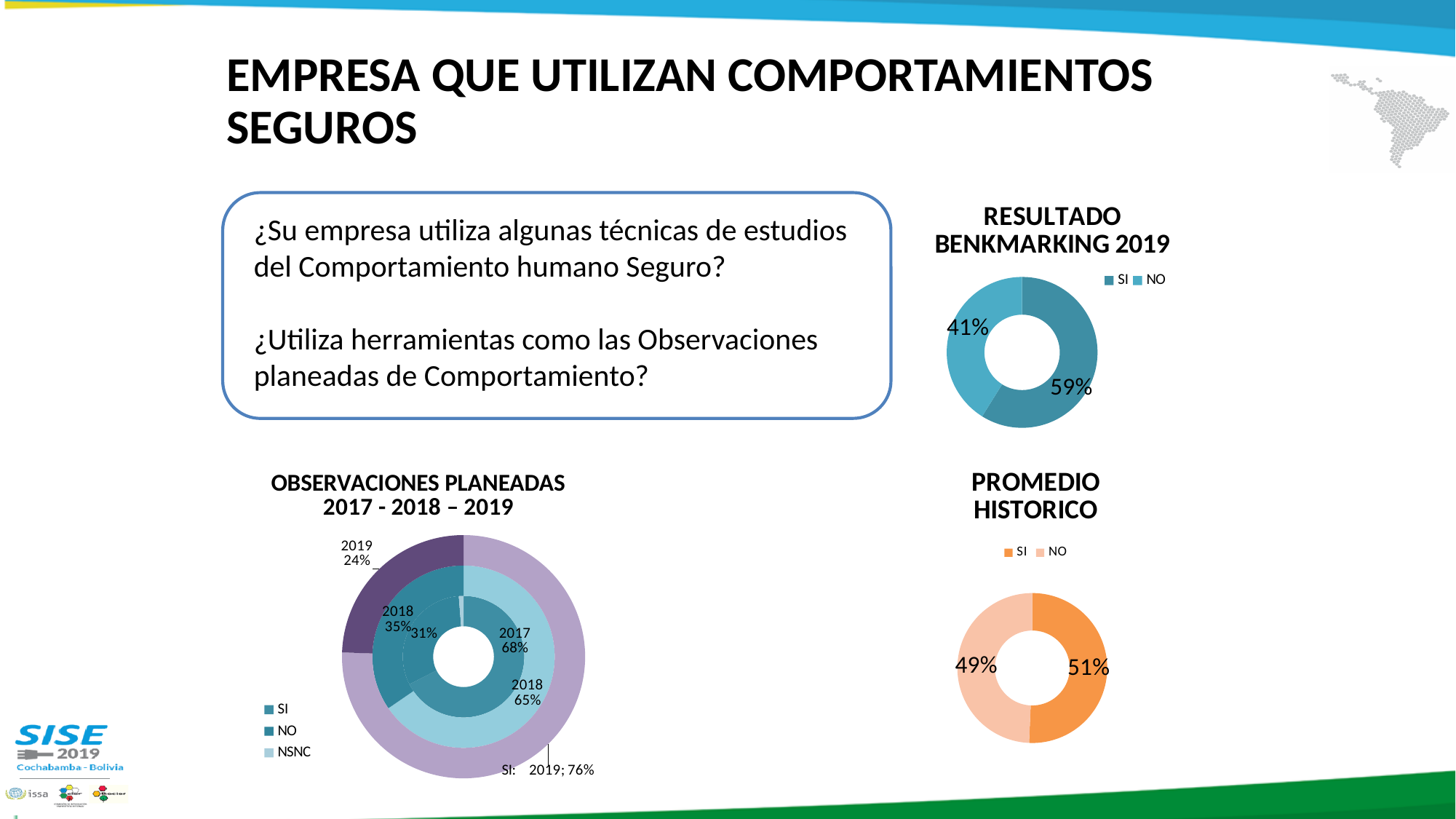
How many series does the legend of the PROMEDIO HISTORICO chart list? 2 In the OBSERVACIONES PLANEADAS 2017 - 2018 – 2019 chart, what is the NO percentage for 2018? 35% In the OBSERVACIONES PLANEADAS 2017 - 2018 – 2019 chart, what is the SI percentage for 2017? 68% In the RESULTADO BENKMARKING 2019 chart, what percentage answered NO? 41% What kind of chart is the RESULTADO BENKMARKING 2019 chart? Doughnut (pie) chart In the OBSERVACIONES PLANEADAS 2017 - 2018 – 2019 chart, what is the SI percentage for 2019? 76% In the RESULTADO BENKMARKING 2019 chart, what percentage answered SI? 59% In the PROMEDIO HISTORICO chart, what percentage is NO? 49% In the RESULTADO BENKMARKING 2019 chart, which is larger, SI or NO? SI In the RESULTADO BENKMARKING 2019 chart, what is the difference in percentage points between SI and NO? 18 percentage points How many entries does the legend of the OBSERVACIONES PLANEADAS 2017 - 2018 – 2019 chart list? 3 In the PROMEDIO HISTORICO chart, what percentage is SI? 51%